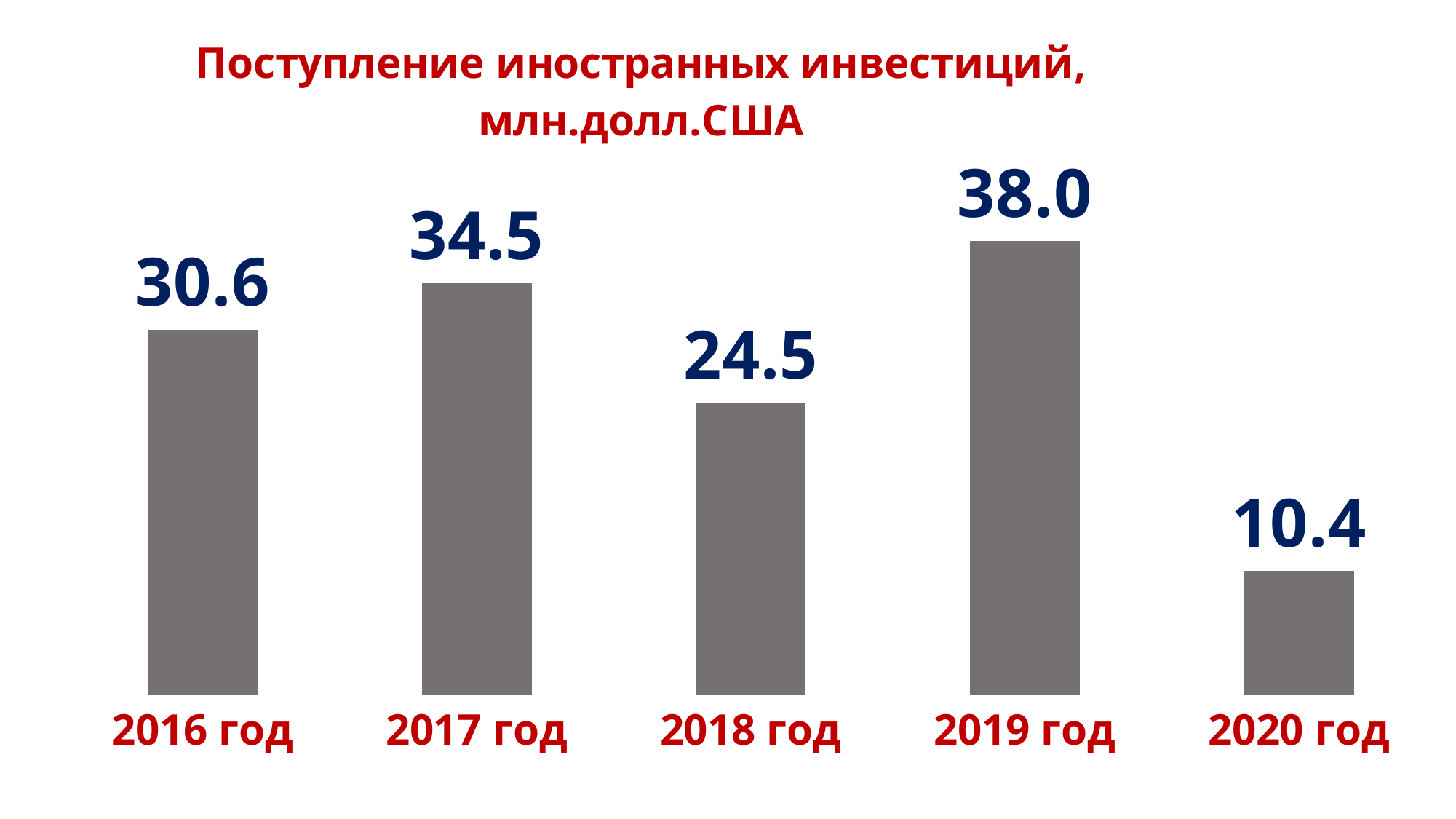
What is the difference between the values for 2019 год and 2020 год? 27.6 What is the title of the chart? Поступление иностранных инвестиций, млн.долл.США What is the value for 2020 год? 10.4 What is the value for 2016 год? 30.6 How many years are shown on the chart? 5 Which year has the lowest value? 2020 год Which year has the highest value? 2019 год What kind of chart is shown on the slide? Bar chart Which is larger, the value for 2017 год or the value for 2018 год? 2017 год Does the value fall or rise from 2019 год to 2020 год? Fall What is the value for 2018 год? 24.5 What is the difference between the values for 2017 год and 2016 год? 3.9